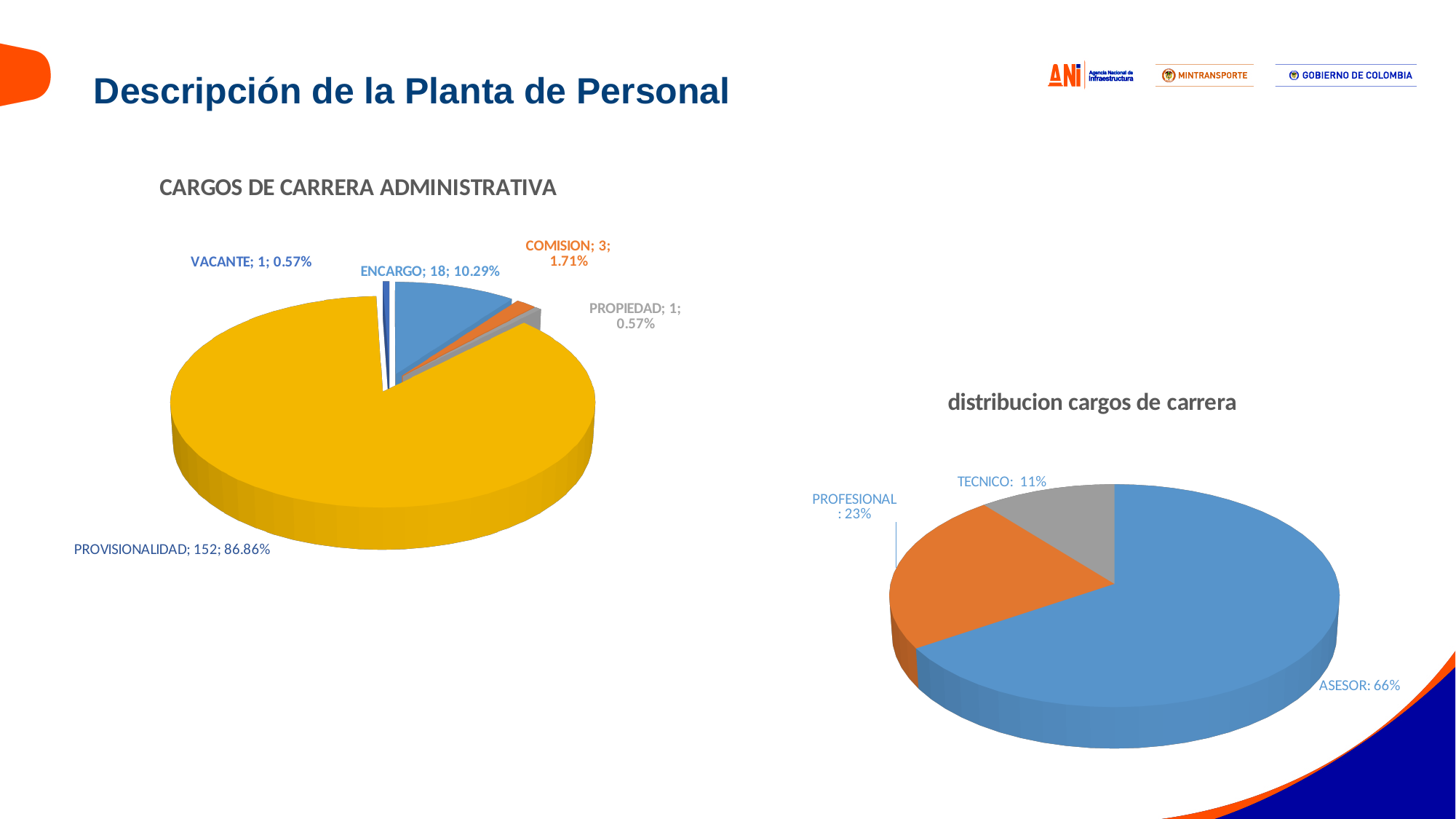
In the 'CARGOS DE CARRERA ADMINISTRATIVA' chart, which is larger, COMISION or PROPIEDAD? COMISION In the 'CARGOS DE CARRERA ADMINISTRATIVA' chart, what percentage is shown for COMISION? 1.71% In the 'distribucion cargos de carrera' chart, what is the difference in percentage points between PROFESIONAL and TECNICO? 12 In the 'CARGOS DE CARRERA ADMINISTRATIVA' chart, what is the difference between the PROVISIONALIDAD and ENCARGO counts? 134 In the 'CARGOS DE CARRERA ADMINISTRATIVA' chart, what is the value for ENCARGO? 18 In the 'distribucion cargos de carrera' chart, what colour is the PROFESIONAL slice? Orange In the 'distribucion cargos de carrera' chart, which category has the smallest slice? TECNICO In the 'CARGOS DE CARRERA ADMINISTRATIVA' chart, how many slices does the pie have? 5 In the 'CARGOS DE CARRERA ADMINISTRATIVA' chart, what kind of chart is shown? Pie chart In the 'CARGOS DE CARRERA ADMINISTRATIVA' chart, which category has the largest slice? PROVISIONALIDAD In the 'CARGOS DE CARRERA ADMINISTRATIVA' chart, what share of the pie does PROVISIONALIDAD represent? 86.86% In the 'distribucion cargos de carrera' chart, what share does ASESOR represent? 66%